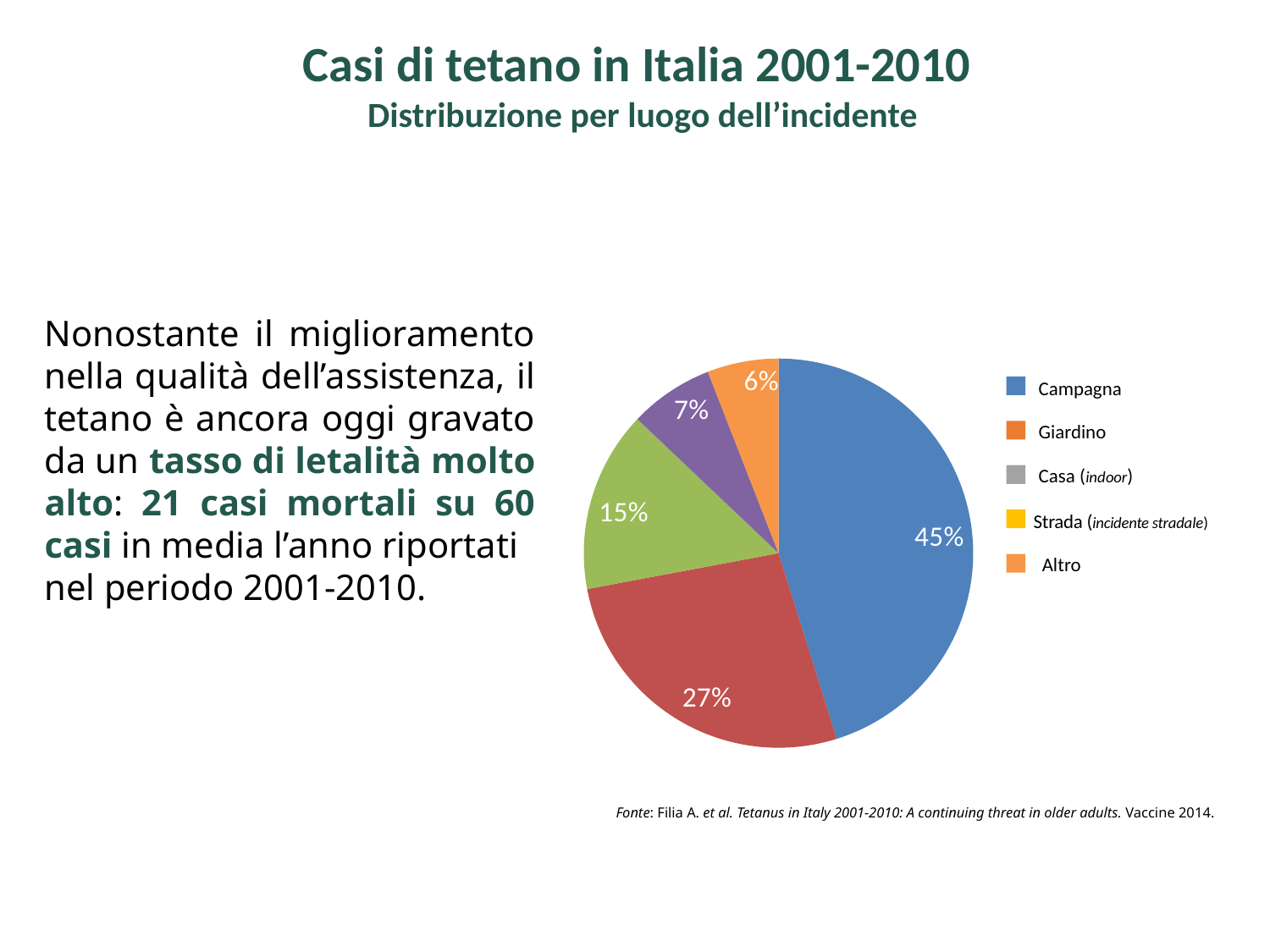
How many entries does the legend list? 5 What share of the pie does Casa (indoor) account for? 15% What share of the pie does Giardino account for? 27% How many slices does the pie chart have? 5 Which category has the largest slice of the pie? Campagna What is the difference in percentage points between the Campagna slice and the Giardino slice? 18 Which is larger, the Giardino slice or the Casa (indoor) slice? Giardino What share of the pie does Altro account for? 6% What is the subtitle of the chart shown on the slide? Distribuzione per luogo dell'incidente Which category has the smallest slice of the pie? Altro What kind of chart is shown on the slide? pie chart